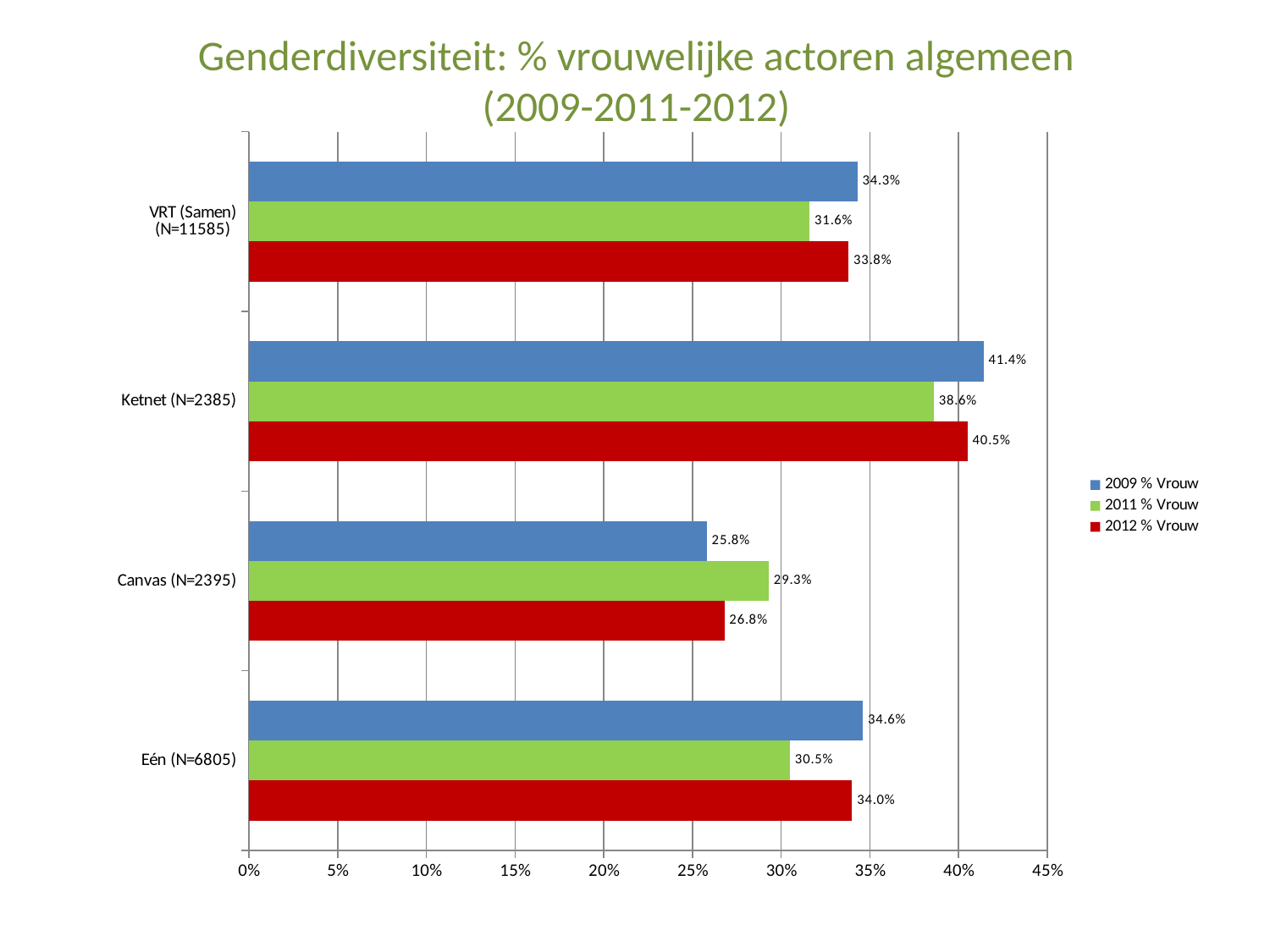
What is the 2012 % Vrouw value for Eén (N=6805)? 34.0% What is the difference between the 2009 % Vrouw and 2011 % Vrouw values for VRT (Samen) (N=11585)? 2.7% What is the 2009 % Vrouw value for Ketnet (N=2385)? 41.4% How many series does the legend list? 3 Which category has the highest 2012 % Vrouw value? Ketnet (N=2385) Is the 2011 % Vrouw value for Ketnet (N=2385) greater or less than 35%? greater Which is larger for Canvas (N=2395): the 2011 % Vrouw value or the 2012 % Vrouw value? 2011 % Vrouw How many categories are shown on the chart? 4 Which category has the lowest 2009 % Vrouw value? Canvas (N=2395) What kind of chart is shown on the slide? bar chart What is the title of the chart? Genderdiversiteit: % vrouwelijke actoren algemeen (2009-2011-2012) What is the 2011 % Vrouw value for Canvas (N=2395)? 29.3%